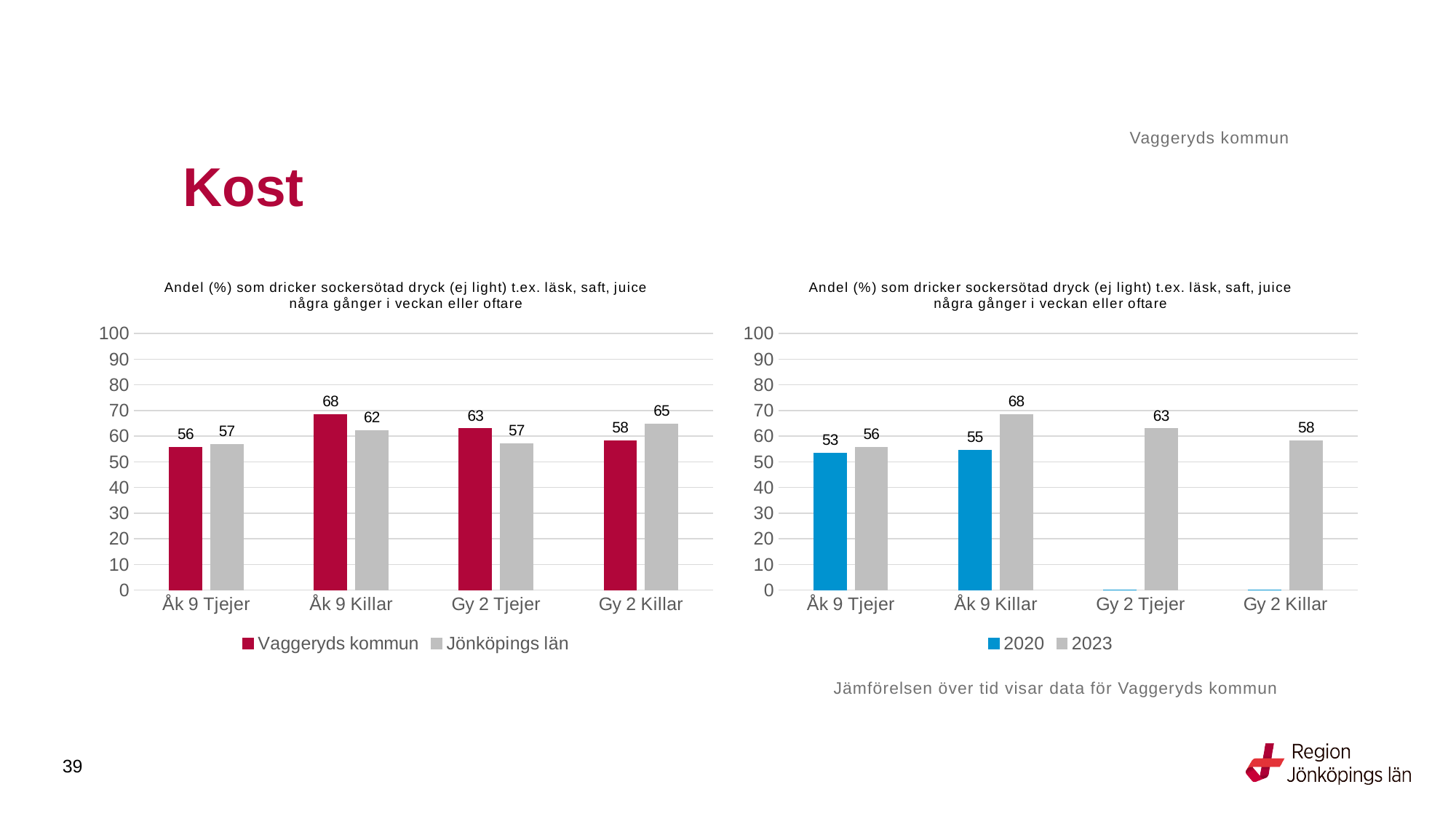
In the right chart, what is the value for 2020 for Åk 9 Tjejer? 53 In the left chart, which is larger for Gy 2 Killar: Vaggeryds kommun or Jönköpings län? Jönköpings län How many categories are shown on the x axis of the left chart? 4 How many series does the legend of the right chart list? 2 In the right chart, what is the difference between 2023 and 2020 for Åk 9 Killar? 13 In the left chart, what is the difference between Vaggeryds kommun and Jönköpings län for Gy 2 Tjejer? 6 In the left chart, which category has the lowest value for Jönköpings län? Åk 9 Tjejer and Gy 2 Tjejer (both 57) In the right chart, what is the value for 2023 for Gy 2 Tjejer? 63 In the left chart, what is the value for Jönköpings län for Gy 2 Killar? 65 What type of chart is the left chart? Bar chart In the left chart, what is the value for Vaggeryds kommun for Åk 9 Killar? 68 In the left chart, which category has the highest value for Vaggeryds kommun? Åk 9 Killar